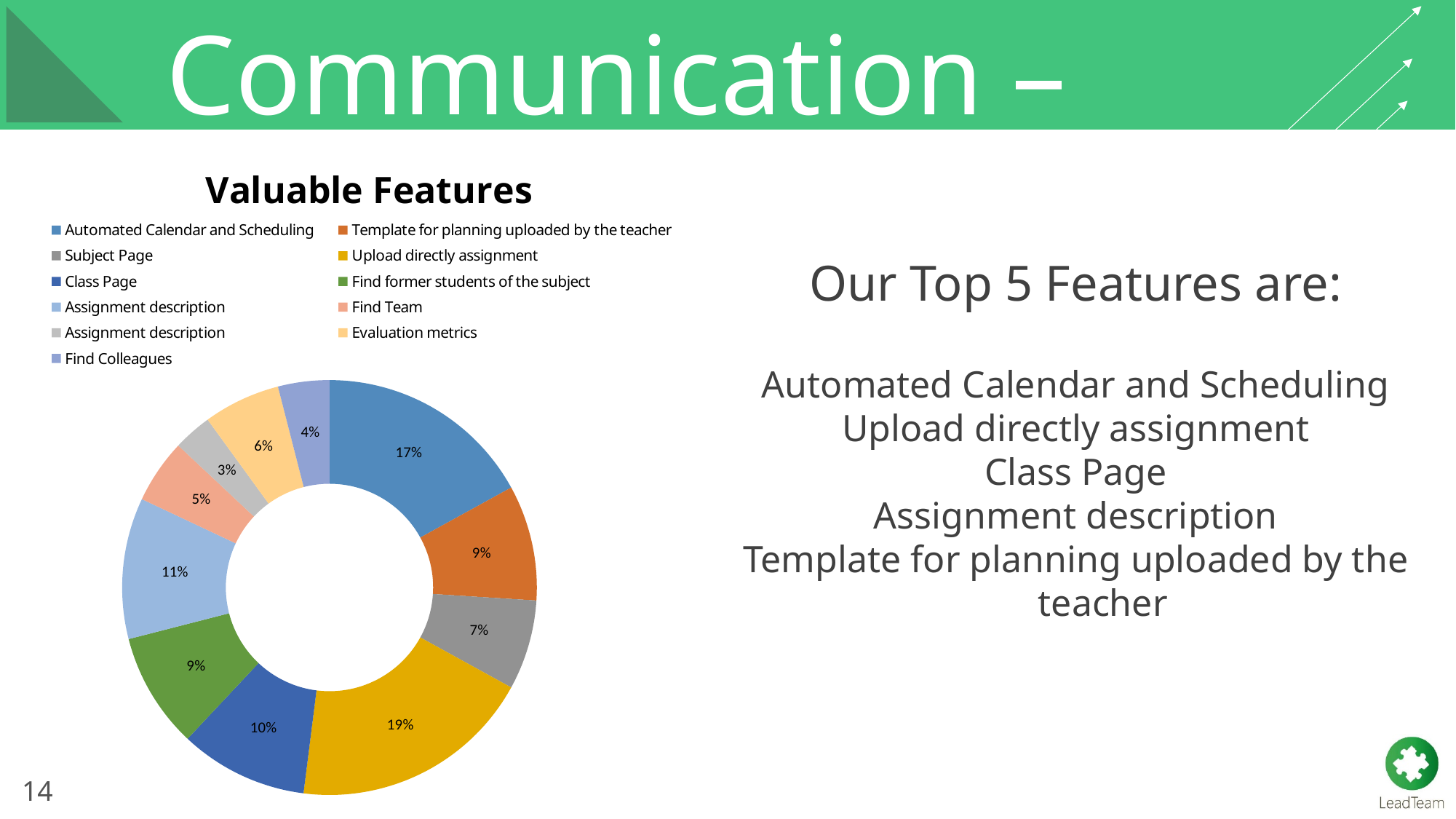
How many percentage points larger is Upload directly assignment than Automated Calendar and Scheduling? 2 What percentage is shown for Subject Page? 7% What percentage is shown for Automated Calendar and Scheduling? 17% What percentage is shown for Find Team? 5% What percentage is shown for Find Colleagues? 4% What percentage is shown for Class Page? 10% What percentage is shown for Evaluation metrics? 6% What is the smallest percentage shown on the chart? 3% What percentage is shown for Upload directly assignment? 19% What kind of chart is shown on the slide? doughnut chart Which feature has the largest share of the chart? Upload directly assignment What is the title of the chart? Valuable Features